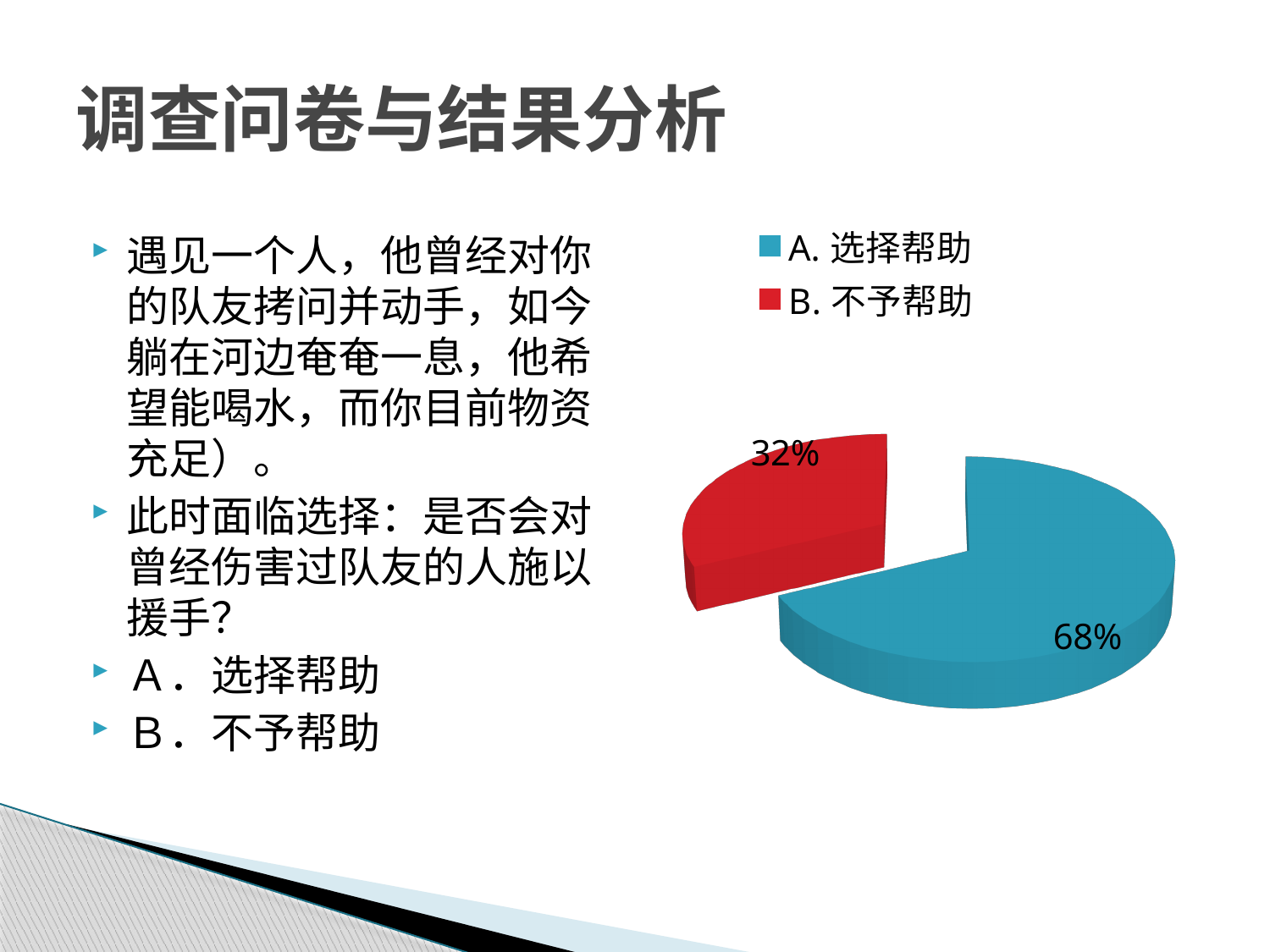
How many slices does the pie chart have? 2 What kind of chart is shown on the slide? pie chart What percentage of the pie is labelled for B. 不予帮助? 32% Which category has the smallest share of the pie? B. 不予帮助 Which is larger, the share for A. 选择帮助 or the share for B. 不予帮助? A. 选择帮助 How many entries does the legend list? 2 What is the difference in percentage points between A. 选择帮助 and B. 不予帮助? 36 What colour is the slice for A. 选择帮助? blue What percentage of the pie is labelled for A. 选择帮助? 68% What colour is the slice for B. 不予帮助? red Which category has the largest share of the pie? A. 选择帮助